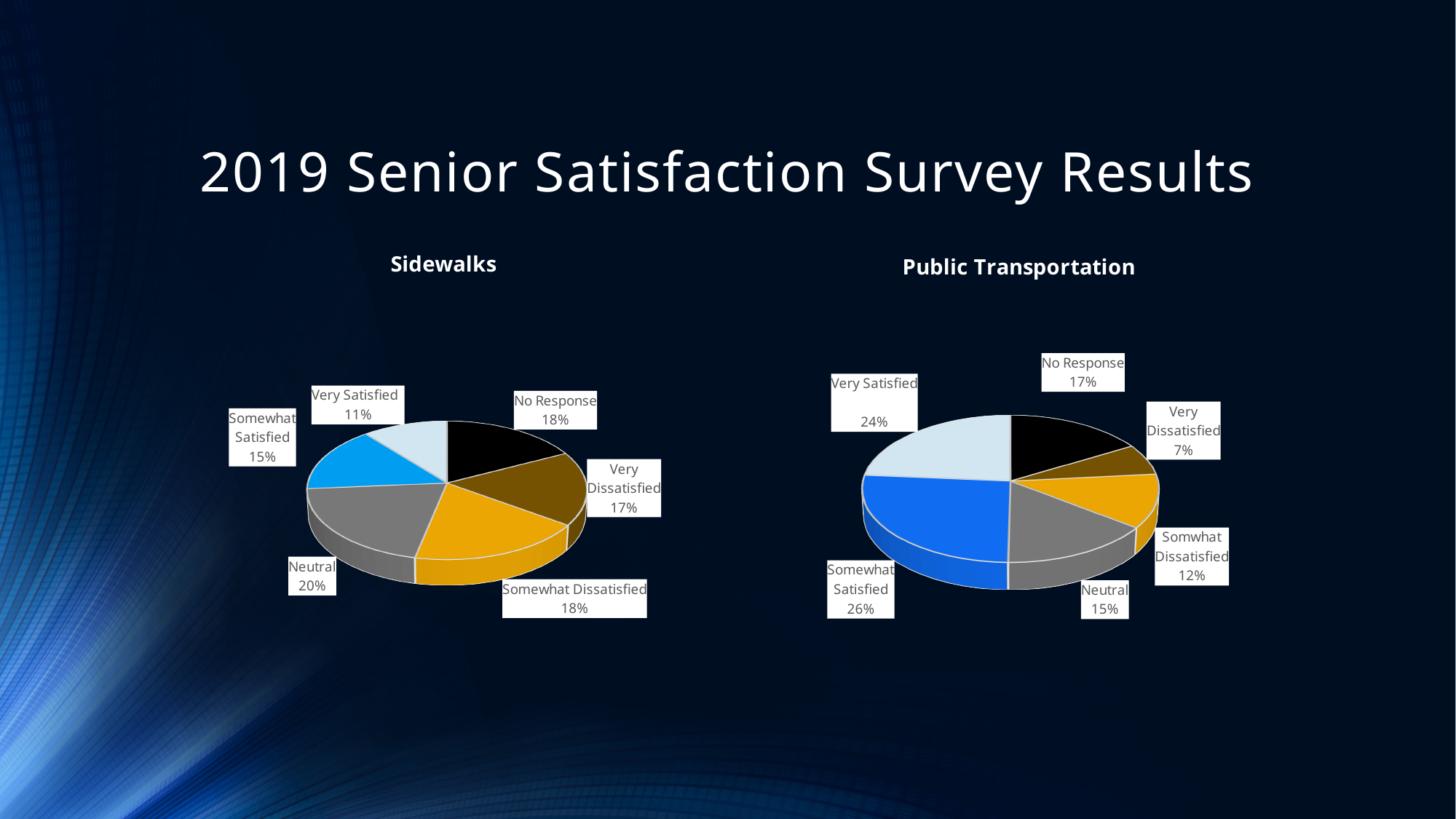
In the Sidewalks chart, what share is labelled Very Satisfied? 11% In the Public Transportation chart, which category has the largest slice? Somewhat Satisfied In the Public Transportation chart, what percentage of respondents were Somewhat Satisfied? 26% In the Sidewalks chart, which category has the smallest slice? Very Satisfied How many categories does the Sidewalks chart show? 6 What kind of chart is the Public Transportation chart? Pie chart In the Sidewalks chart, what percentage of respondents were Neutral? 20% In the Sidewalks chart, which category has the largest slice? Neutral In the Public Transportation chart, which is larger: Very Satisfied or No Response? Very Satisfied In the Sidewalks chart, what is the difference between the Neutral and Very Satisfied percentages? 9% In the Public Transportation chart, what share is labelled Very Dissatisfied? 7% In the Public Transportation chart, which category has the smallest slice? Very Dissatisfied